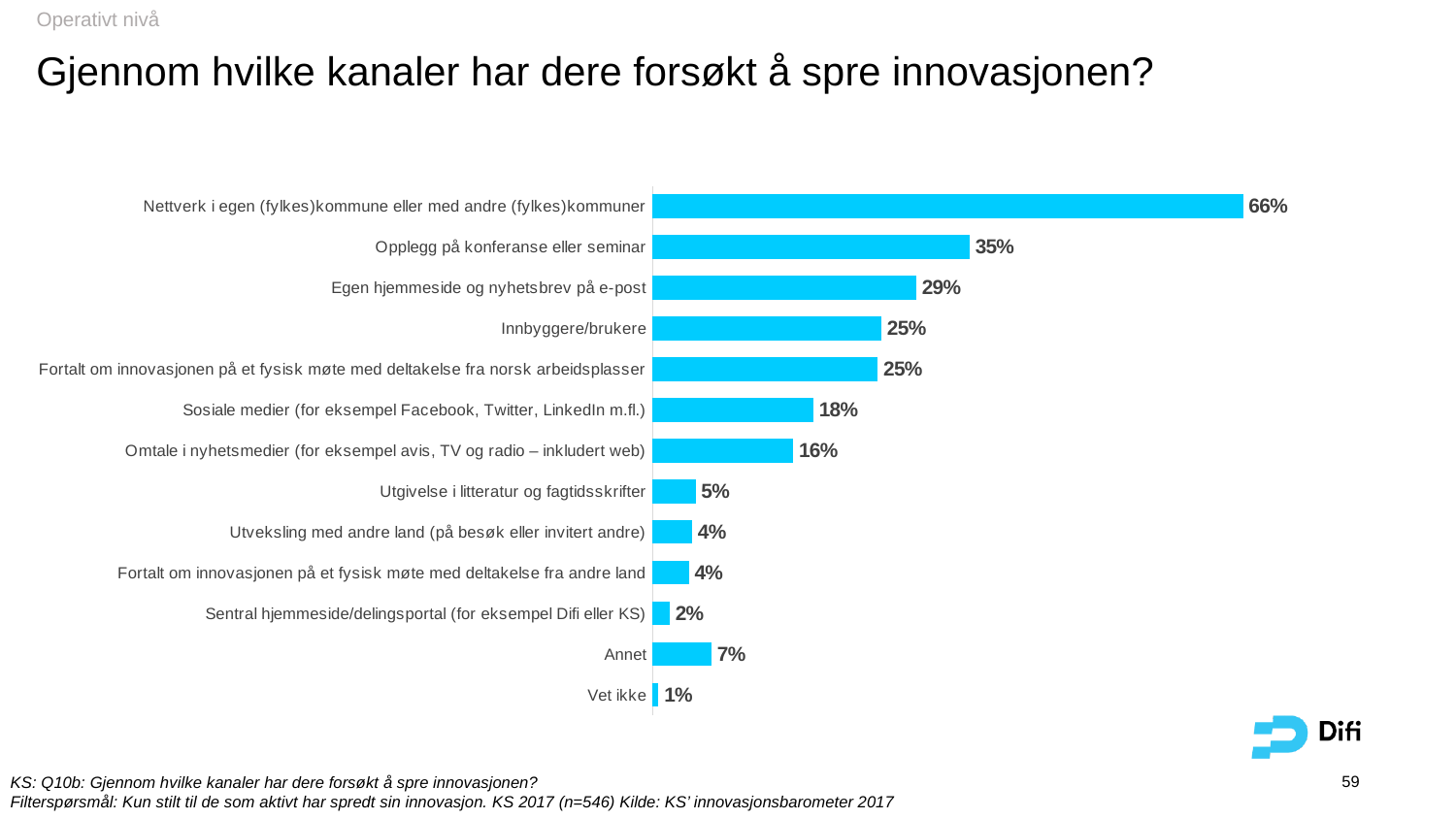
How many categories are shown in the chart? 13 What is the difference between "Nettverk i egen (fylkes)kommune eller med andre (fylkes)kommuner" and "Opplegg på konferanse eller seminar"? 31 percentage points Which is larger: "Utgivelse i litteratur og fagtidsskrifter" or "Annet"? Annet What is the value for "Opplegg på konferanse eller seminar"? 35% What is the difference between "Egen hjemmeside og nyhetsbrev på e-post" and "Omtale i nyhetsmedier (for eksempel avis, TV og radio – inkludert web)"? 13 percentage points Which category has the lowest value? Vet ikke What kind of chart is shown on the slide? Bar chart What is the value for "Sosiale medier (for eksempel Facebook, Twitter, LinkedIn m.fl.)"? 18% Which category has the highest value? Nettverk i egen (fylkes)kommune eller med andre (fylkes)kommuner What is the title of the slide? Gjennom hvilke kanaler har dere forsøkt å spre innovasjonen? Which is larger: "Sosiale medier (for eksempel Facebook, Twitter, LinkedIn m.fl.)" or "Innbyggere/brukere"? Innbyggere/brukere What is the value for "Annet"? 7%